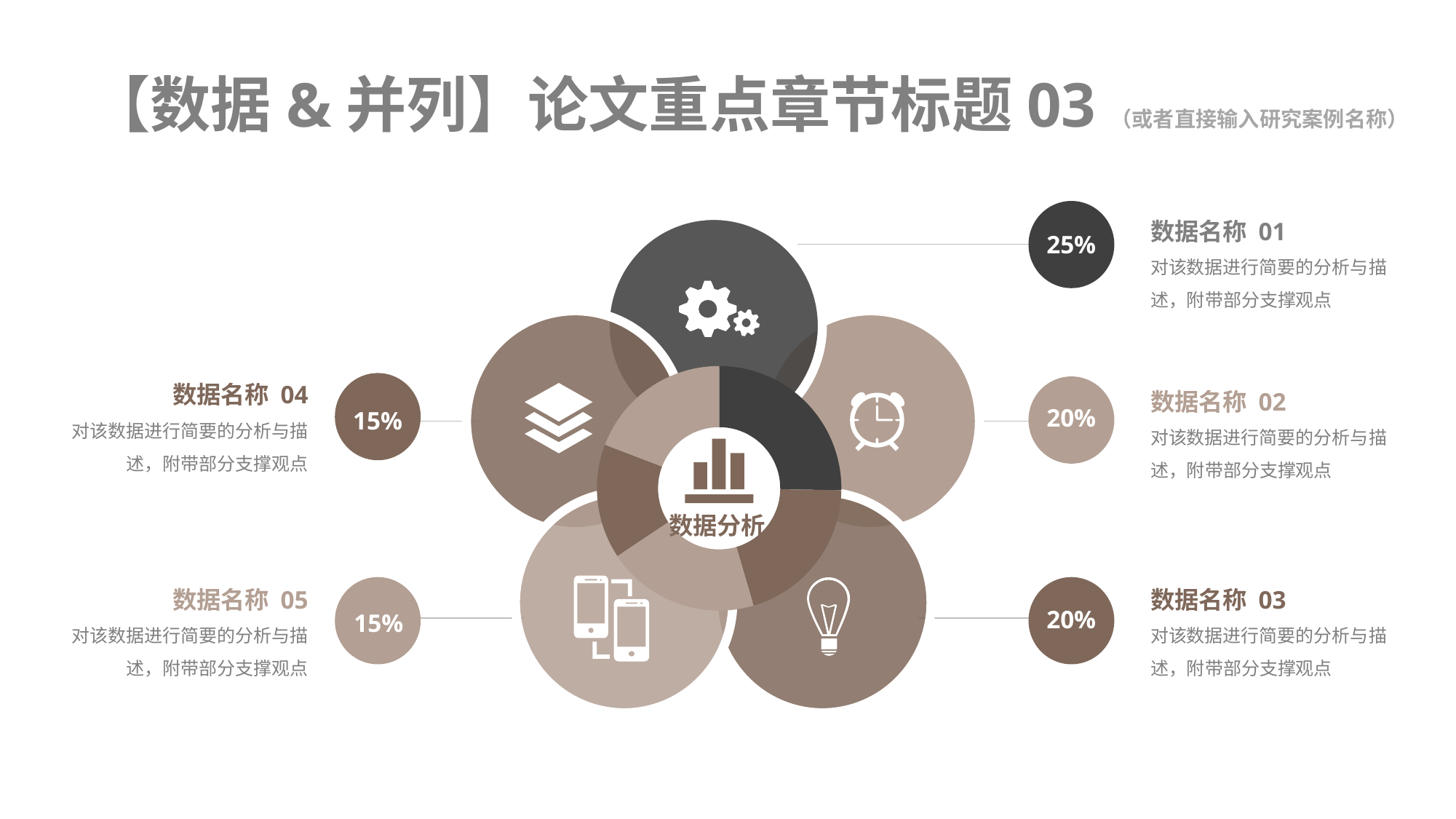
What is the total of all five percentages shown? 95% What is the value shown for 数据名称 05? 15% What is the value shown for 数据名称 04? 15% What is the difference between the values for 数据名称 02 and 数据名称 05? 5% How many data items are shown around the central chart? 5 What is the value shown for 数据名称 02? 20% What is the value shown for 数据名称 01? 25% What text is written in the center of the chart? 数据分析 Which is larger, the value for 数据名称 03 or the value for 数据名称 05? 数据名称 03 Which data item has the highest percentage? 数据名称 01 What is the difference between the values for 数据名称 01 and 数据名称 04? 10% What kind of chart is at the center of the slide? doughnut chart